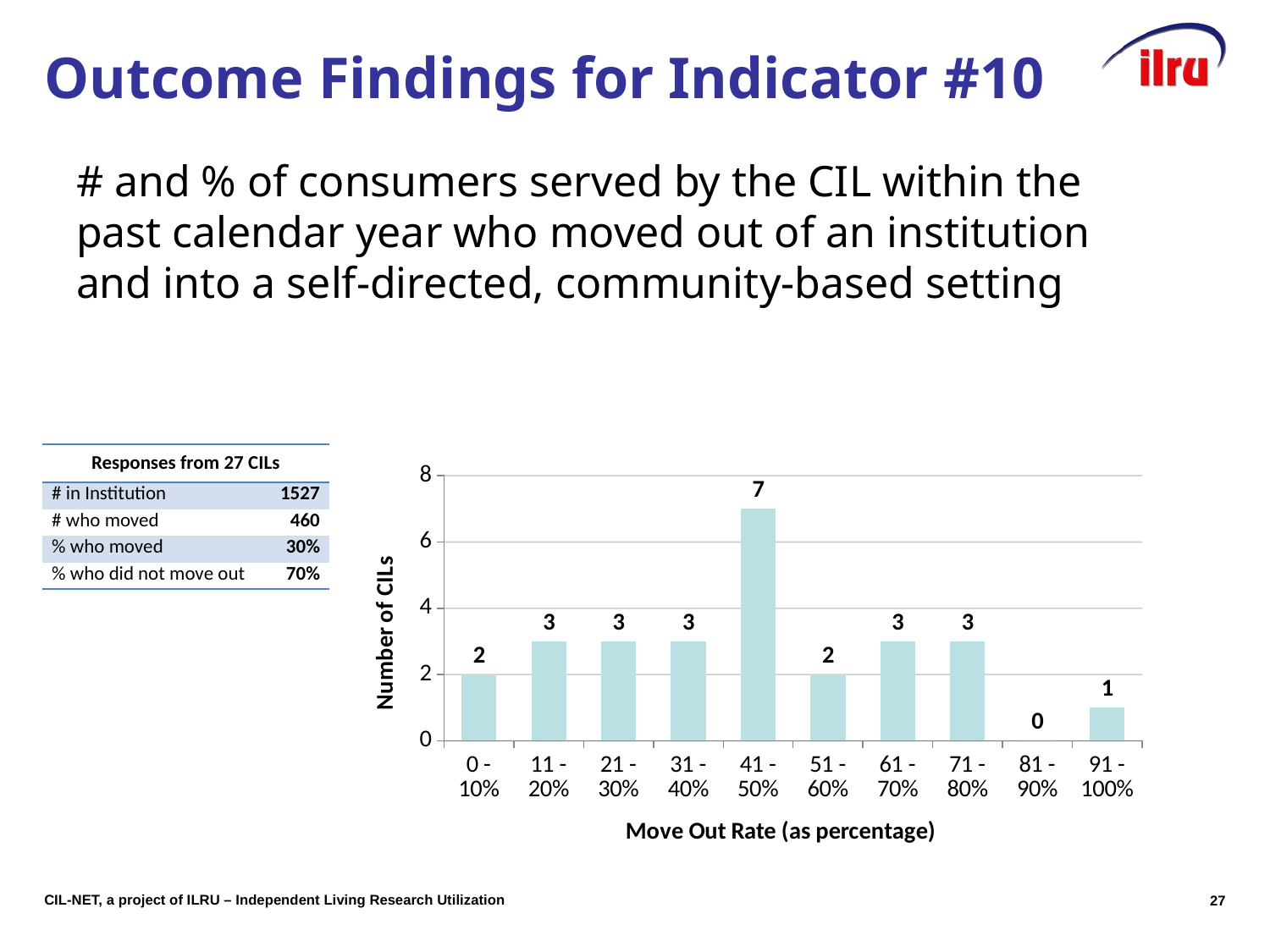
How many move out rate ranges are shown on the x axis? 10 How many CILs had a move out rate of 41 - 50%? 7 Which move out rate range has the highest number of CILs? 41 - 50% Which has more CILs: the 11 - 20% range or the 91 - 100% range? 11 - 20% What is the label of the y axis of the chart? Number of CILs Which move out rate range has the lowest number of CILs? 81 - 90% What is the difference between the number of CILs in the 41 - 50% range and the 51 - 60% range? 5 What is the label of the x axis of the chart? Move Out Rate (as percentage) How many CILs had a move out rate of 0 - 10%? 2 Is the number of CILs in the 41 - 50% range greater or less than 6? greater How many CILs had a move out rate of 91 - 100%? 1 What type of chart is shown on the slide? bar chart